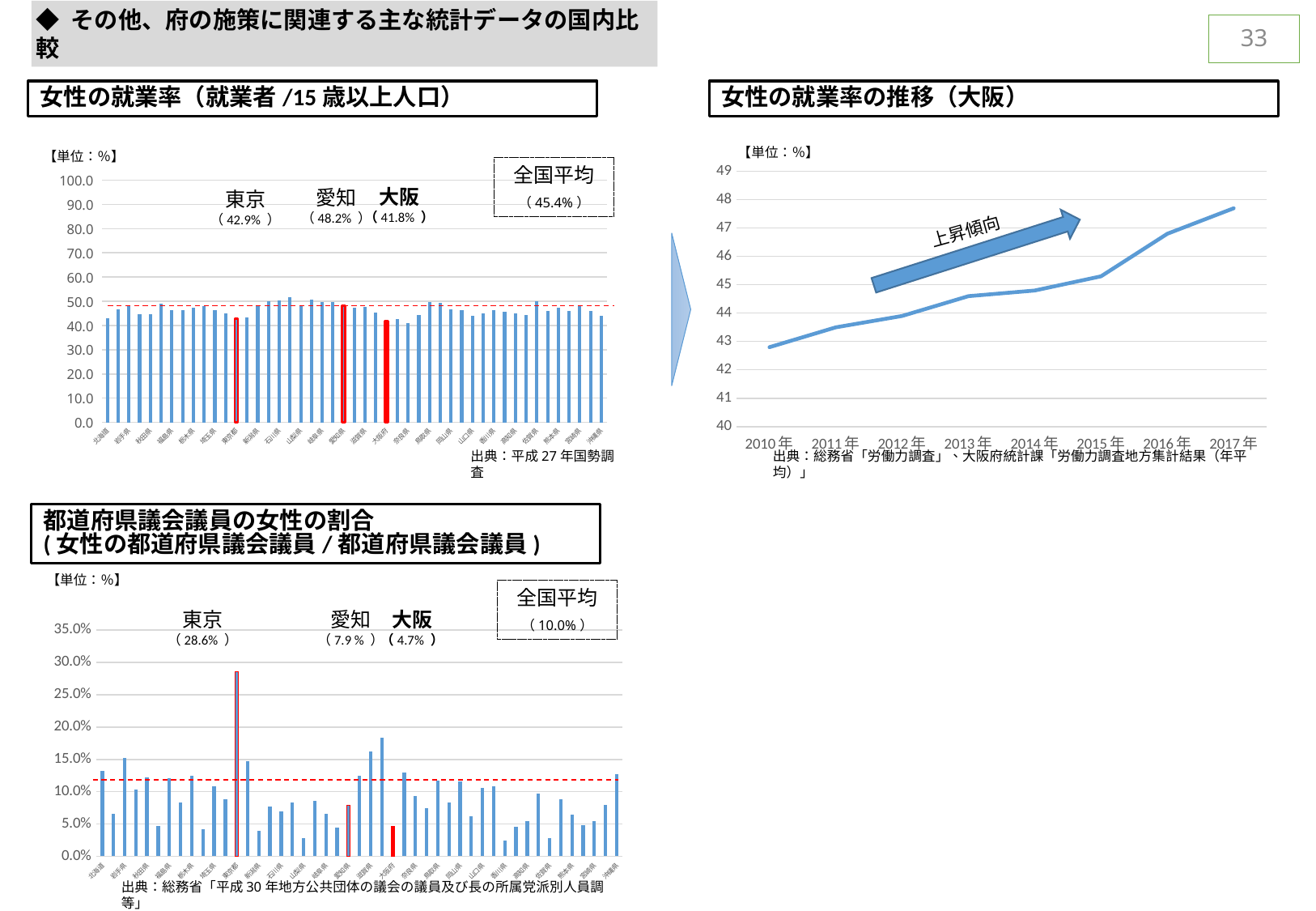
In the 女性の就業率（就業者/15歳以上人口） chart, which has the larger value, 東京 or 大阪? 東京 In the 都道府県議会議員の女性の割合 chart, what is the value shown for 東京? 28.6% In the 女性の就業率の推移（大阪） chart, is the value for 2017年 greater or less than 47? greater What kind of chart is the 女性の就業率の推移（大阪） chart? line chart In the 女性の就業率の推移（大阪） chart, do the values rise or fall from 2010年 to 2017年? rise In the 女性の就業率（就業者/15歳以上人口） chart, what is the difference between the values for 愛知 and 大阪? 6.4% In the 都道府県議会議員の女性の割合 chart, which prefecture has the highest value? 東京 How many years are plotted in the 女性の就業率の推移（大阪） chart? 8 In the 女性の就業率（就業者/15歳以上人口） chart, what is the 全国平均 value shown? 45.4% In the 女性の就業率（就業者/15歳以上人口） chart, what is the value shown for 愛知? 48.2% In the 都道府県議会議員の女性の割合 chart, what is the difference between the values for 東京 and 大阪? 23.9% In the 女性の就業率（就業者/15歳以上人口） chart, what is the value shown for 東京? 42.9%